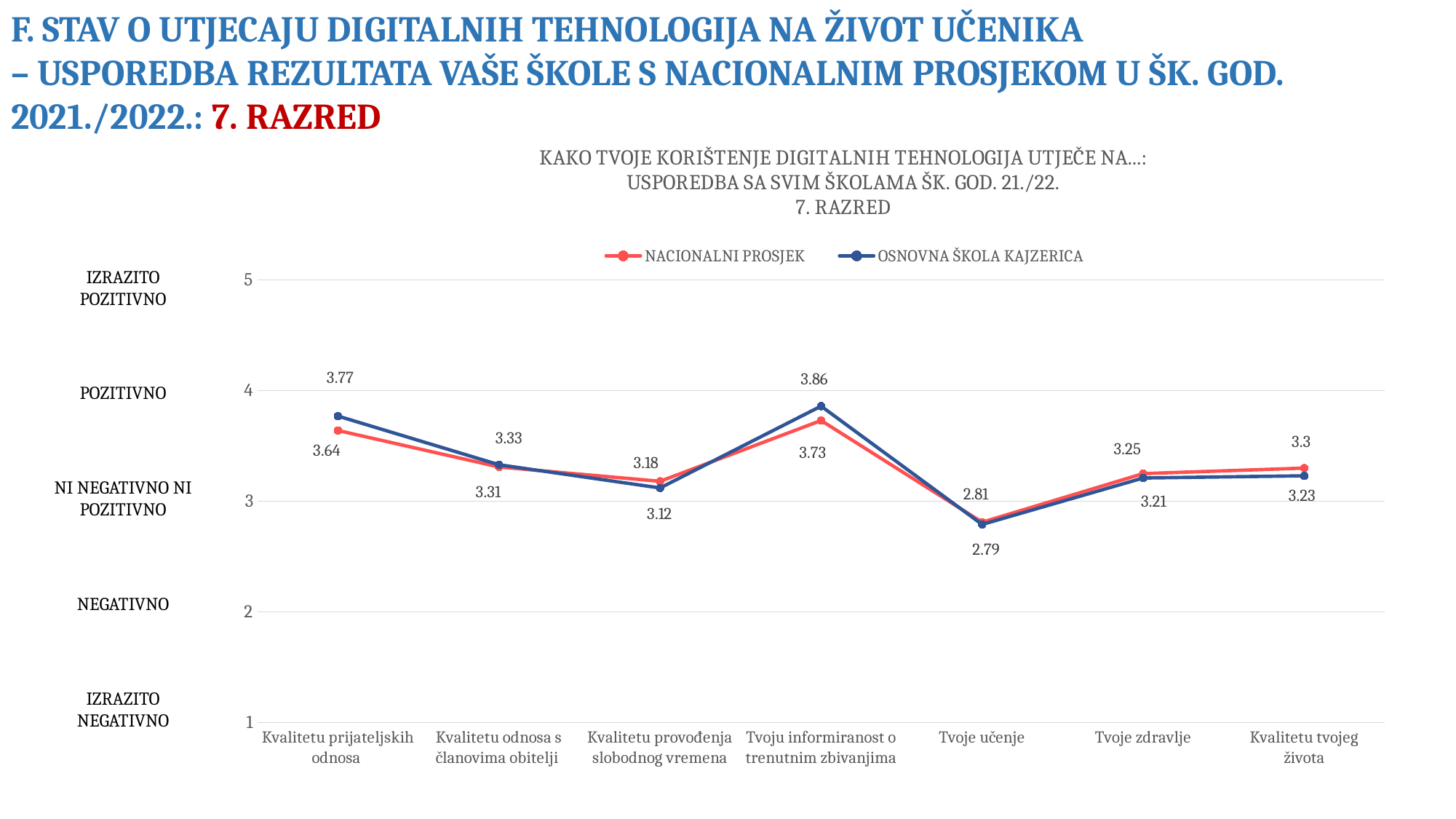
How many series does the legend list? 2 What type of chart is shown on the slide? line chart Which category has the lowest value for NACIONALNI PROSJEK? Tvoje učenje Is the value for NACIONALNI PROSJEK for 'Tvoje učenje' greater or less than 3? less Which category has the highest value for OSNOVNA ŠKOLA KAJZERICA? Tvoju informiranost o trenutnim zbivanjima Which colour is used for the OSNOVNA ŠKOLA KAJZERICA line? blue What is the value for NACIONALNI PROSJEK for 'Kvalitetu prijateljskih odnosa'? 3.64 What is the value for OSNOVNA ŠKOLA KAJZERICA for 'Tvoju informiranost o trenutnim zbivanjima'? 3.86 How many categories are shown on the x axis? 7 For 'Kvalitetu provođenja slobodnog vremena', which series has the larger value, NACIONALNI PROSJEK or OSNOVNA ŠKOLA KAJZERICA? NACIONALNI PROSJEK What is the value for OSNOVNA ŠKOLA KAJZERICA for 'Tvoje učenje'? 2.79 What is the difference between OSNOVNA ŠKOLA KAJZERICA and NACIONALNI PROSJEK for 'Kvalitetu prijateljskih odnosa'? 0.13